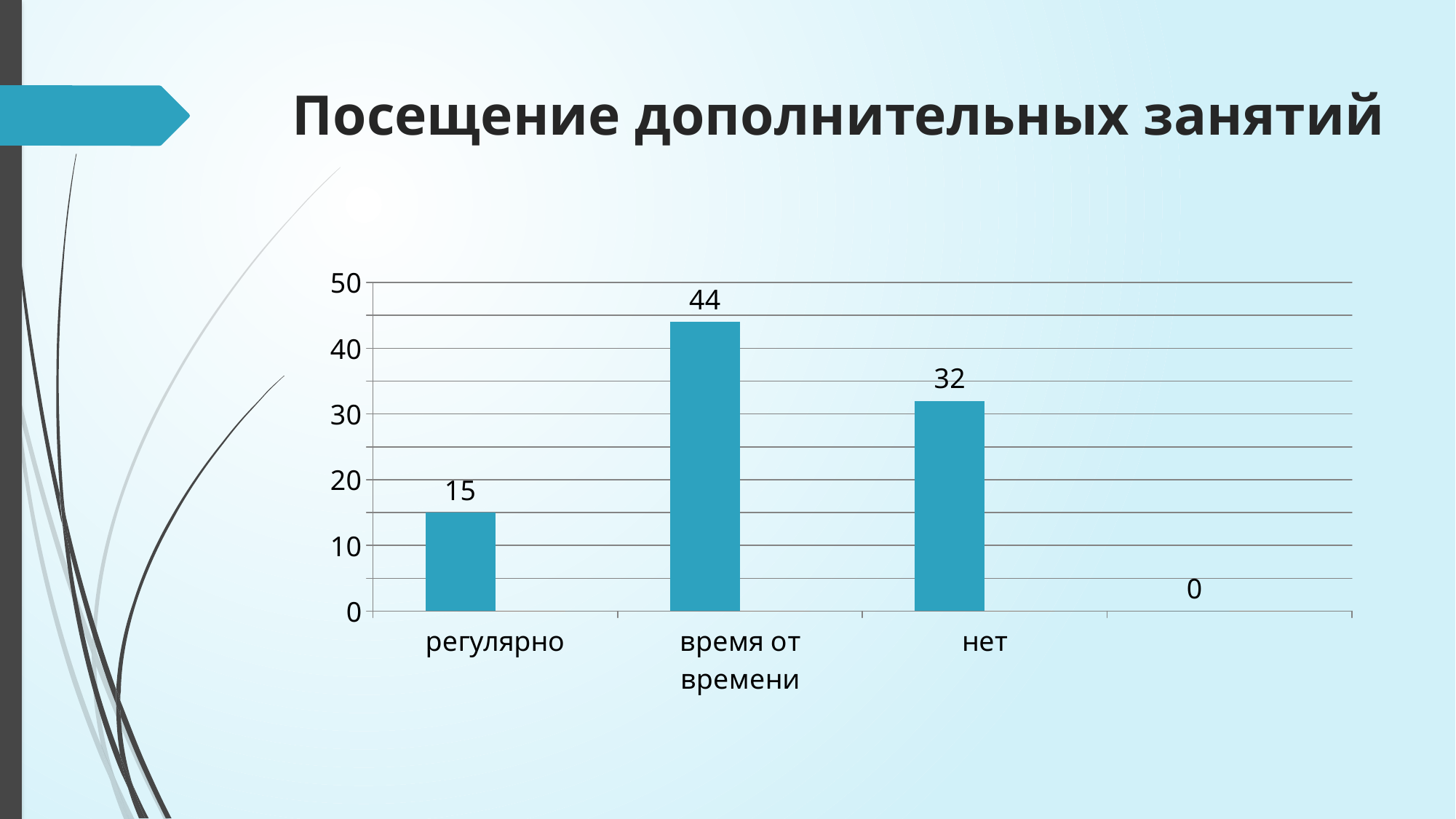
What is the title of the slide? Посещение дополнительных занятий What is the difference between the values for "нет" and "регулярно"? 17 Which is larger, the value for "регулярно" or the value for "нет"? нет What is the value for "нет"? 32 Which category has the highest value? время от времени What is the difference between the values for "время от времени" and "нет"? 12 What kind of chart is shown on the slide? bar chart How many category labels are shown on the x axis? 3 Is the value for "время от времени" greater or less than 40? greater What is the value for "время от времени"? 44 Among the labeled categories, which has the lowest value? регулярно What is the value for "регулярно"? 15